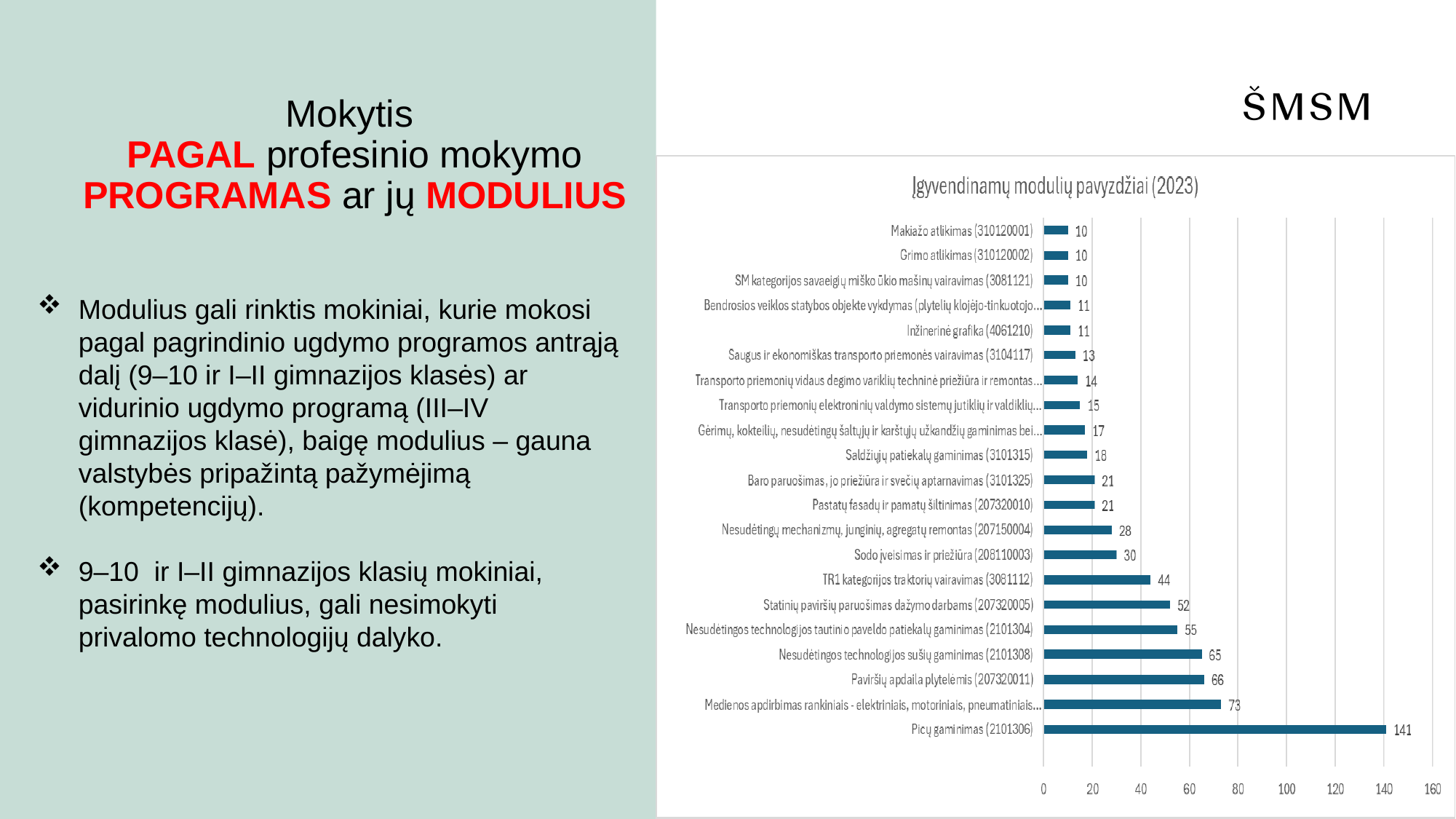
What is the difference between the values for Picų gaminimas (2101306) and Paviršių apdaila plytelėmis (207320011)? 75 What is the value for TR1 kategorijos traktorių vairavimas (3081112)? 44 Is the value for Picų gaminimas (2101306) greater or less than 120? greater Which category has the highest value? Picų gaminimas (2101306) What is the value for Sodo įveisimas ir priežiūra (208110003)? 30 What is the value for Inžinerinė grafika (4061210)? 11 What is the difference between the values for Nesudėtingos technologijos sušių gaminimas (2101308) and Statinių paviršių paruošimas dažymo darbams (207320005)? 13 What is the value for Picų gaminimas (2101306)? 141 How many categories are shown in the chart? 21 What is the title of the chart? Įgyvendinamų modulių pavyzdžiai (2023) Which is larger, the value for Saldžiųjų patiekalų gaminimas (3101315) or the value for Nesudėtingų mechanizmų, junginių, agregatų remontas (207150004)? Nesudėtingų mechanizmų, junginių, agregatų remontas (207150004) What kind of chart is shown on the slide? Bar chart